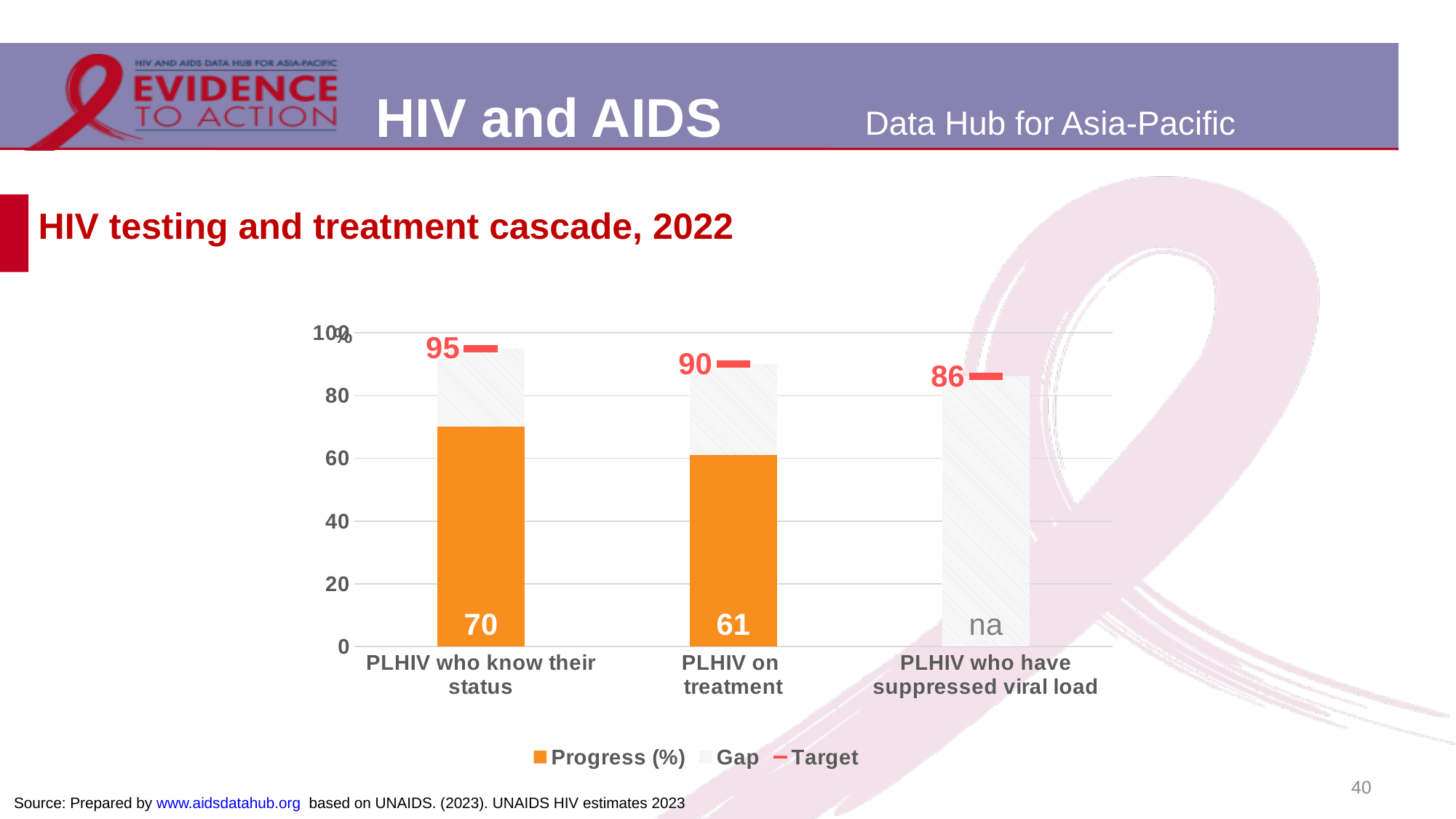
Which category has the highest Target value? PLHIV who know their status What is the difference between the Target and the Progress (%) for PLHIV who know their status? 25 What is the Progress (%) value for PLHIV who know their status? 70 What is the Target value for PLHIV on treatment? 90 What is the Progress (%) value for PLHIV on treatment? 61 Which category has the lowest Target value? PLHIV who have suppressed viral load What is the difference between the Target and the Progress (%) for PLHIV on treatment? 29 What is the Target value for PLHIV who know their status? 95 What kind of chart is shown on the slide? Bar chart What is shown as the Progress (%) value for PLHIV who have suppressed viral load? na What is the Target value for PLHIV who have suppressed viral load? 86 How many series does the legend list? 3